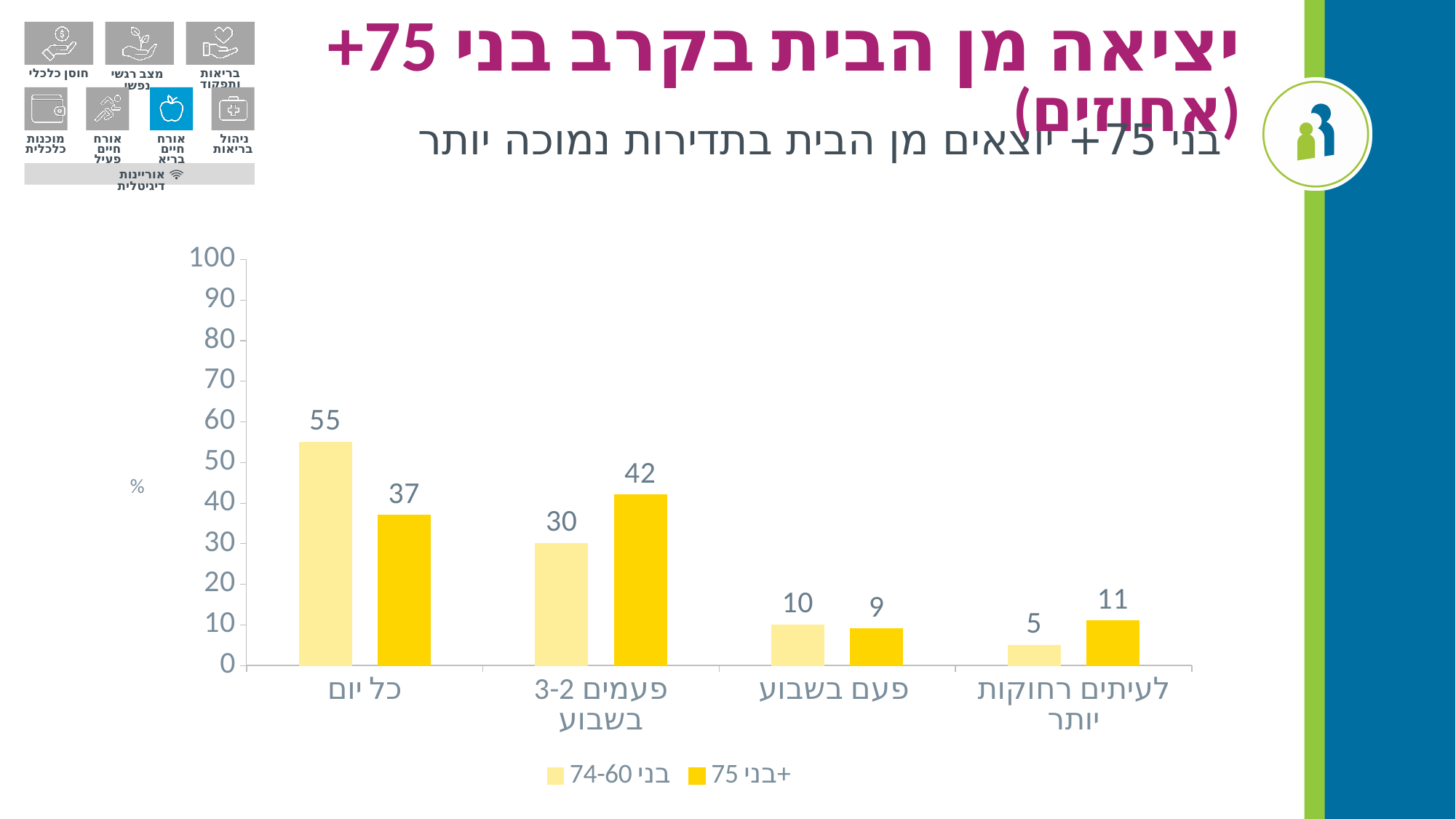
What unit is shown on the y axis label? % What is the value for בני 60-74 in the כל יום category? 55 In the 2-3 פעמים בשבוע category, which series has the larger value, בני 60-74 or בני 75+? בני 75+ How many series does the legend list? 2 Which category has the lowest value for the בני 75+ series? פעם בשבוע What is the difference between the בני 60-74 and בני 75+ values in the כל יום category? 18 Which category has the highest value for the בני 60-74 series? כל יום How many categories are shown on the x axis? 4 What kind of chart is shown on the slide? bar chart What is the value for בני 75+ in the לעיתים רחוקות יותר category? 11 Is the value for בני 75+ in the כל יום category greater or less than 40? less What is the value for בני 75+ in the 2-3 פעמים בשבוע category? 42